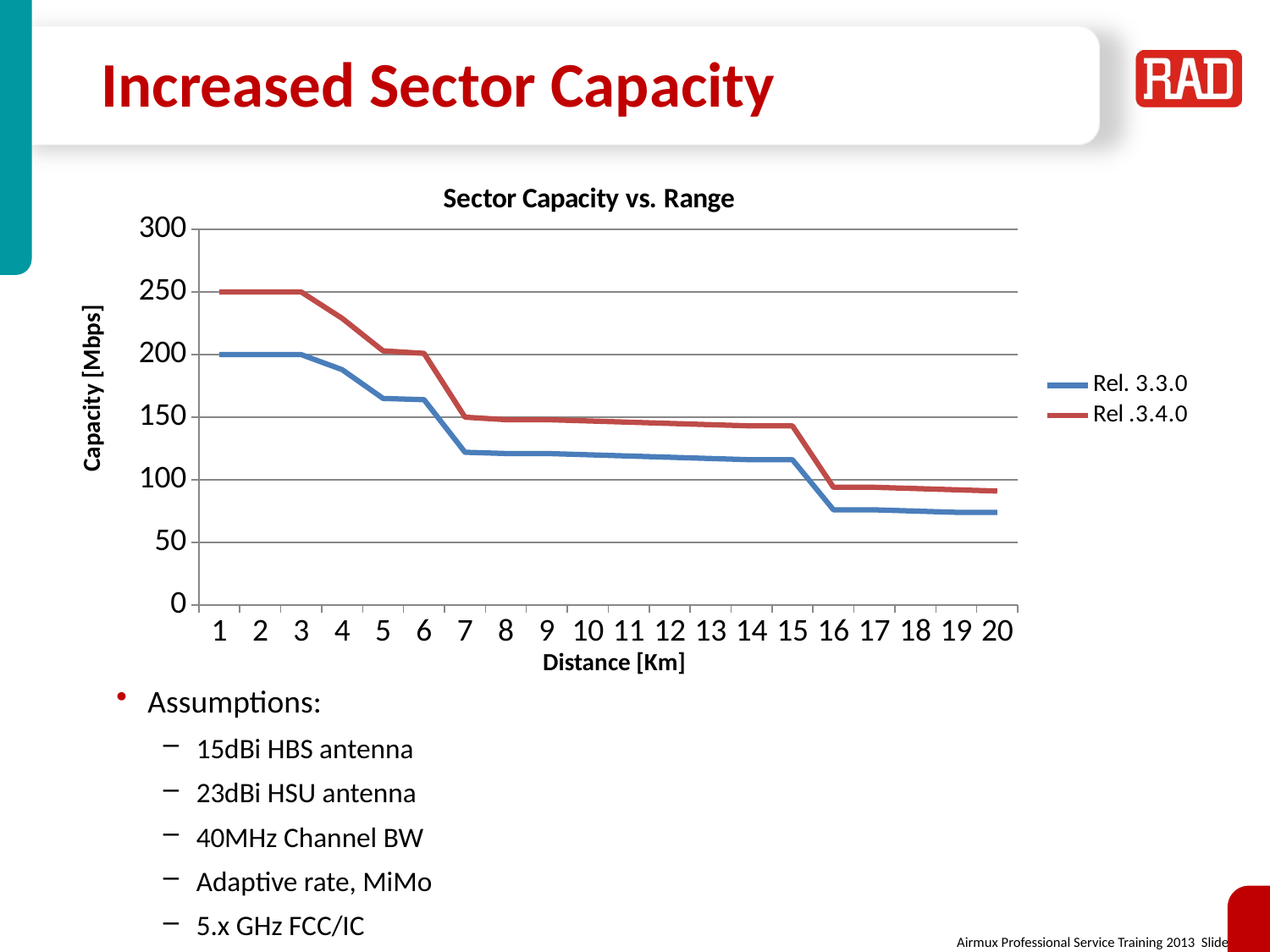
Is the value for Rel .3.4.0 at 10 Km greater or less than 100? greater Do the capacity values rise or fall as distance increases along the x axis? Fall How many series does the legend list? 2 What type of chart is shown on the slide? Line chart How many distance points are plotted along the x axis? 20 What is the capacity for Rel .3.4.0 at a distance of 1 Km? 250 What is the difference in capacity between Rel .3.4.0 and Rel. 3.3.0 at 1 Km? 50 Is the value for Rel. 3.3.0 at 10 Km greater or less than 150? less What is the title of the chart? Sector Capacity vs. Range At 10 Km, which series has the higher capacity, Rel. 3.3.0 or Rel .3.4.0? Rel .3.4.0 What is the capacity for Rel. 3.3.0 at a distance of 1 Km? 200 Is the value for Rel. 3.3.0 at 20 Km greater or less than 100? less